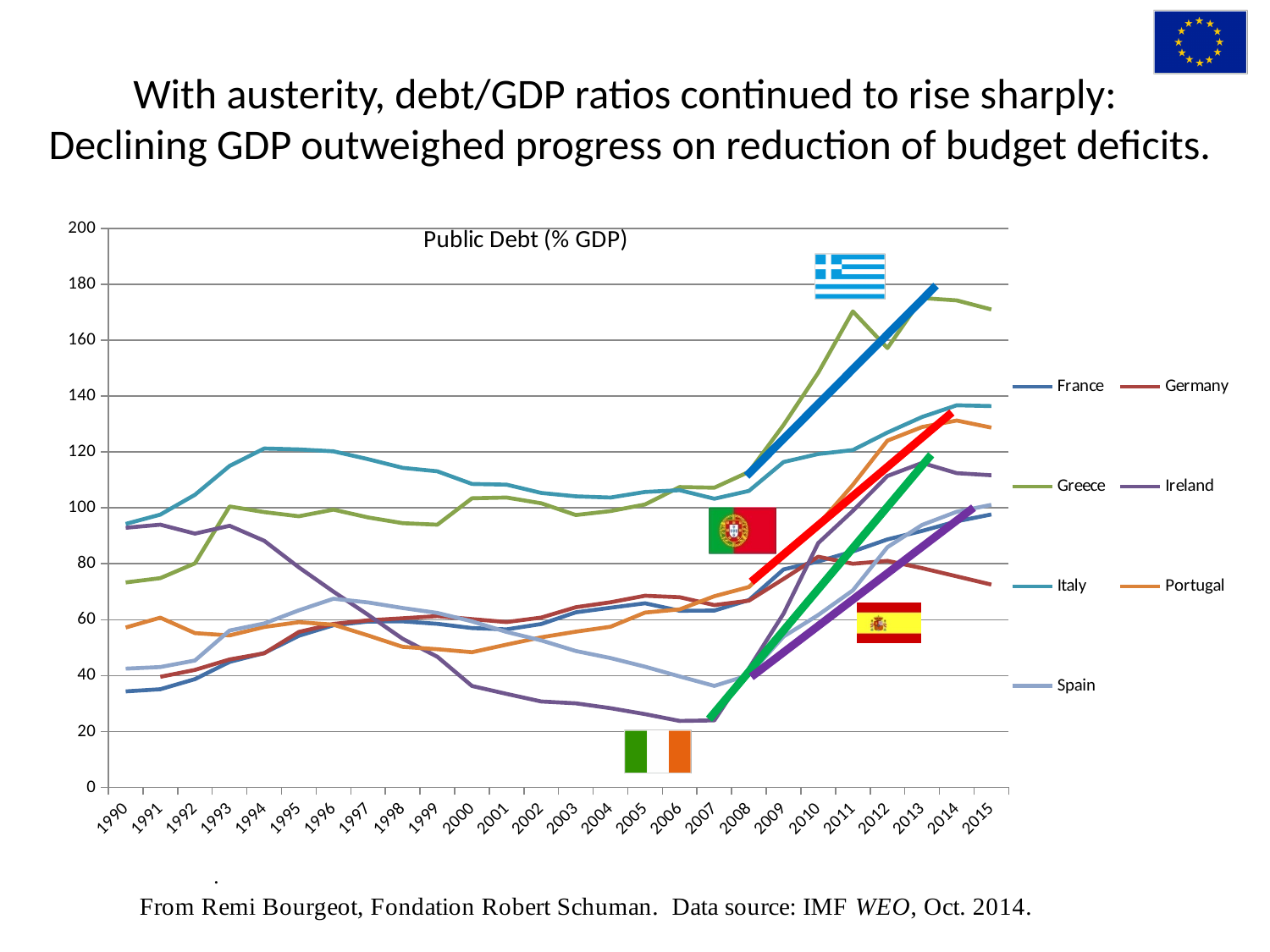
Is the value for Portugal in 2013 greater or less than 120? greater Which country has the highest public debt ratio in 2015? Greece Is the value for Ireland in 2007 greater or less than 40? less How many series does the legend list? 7 How many years are shown along the x axis? 26 Which country has the lowest public debt ratio in 2007? Ireland Does the value for Ireland rise or fall from 1993 to 2007? fall What is the title of the chart? Public Debt (% GDP) What kind of chart is shown on the slide? line chart Which country has the lowest public debt ratio in 2015? Germany Is the value for Greece in 2011 greater or less than 160? greater In 2005, which is larger, the value for Spain or the value for Ireland? Spain